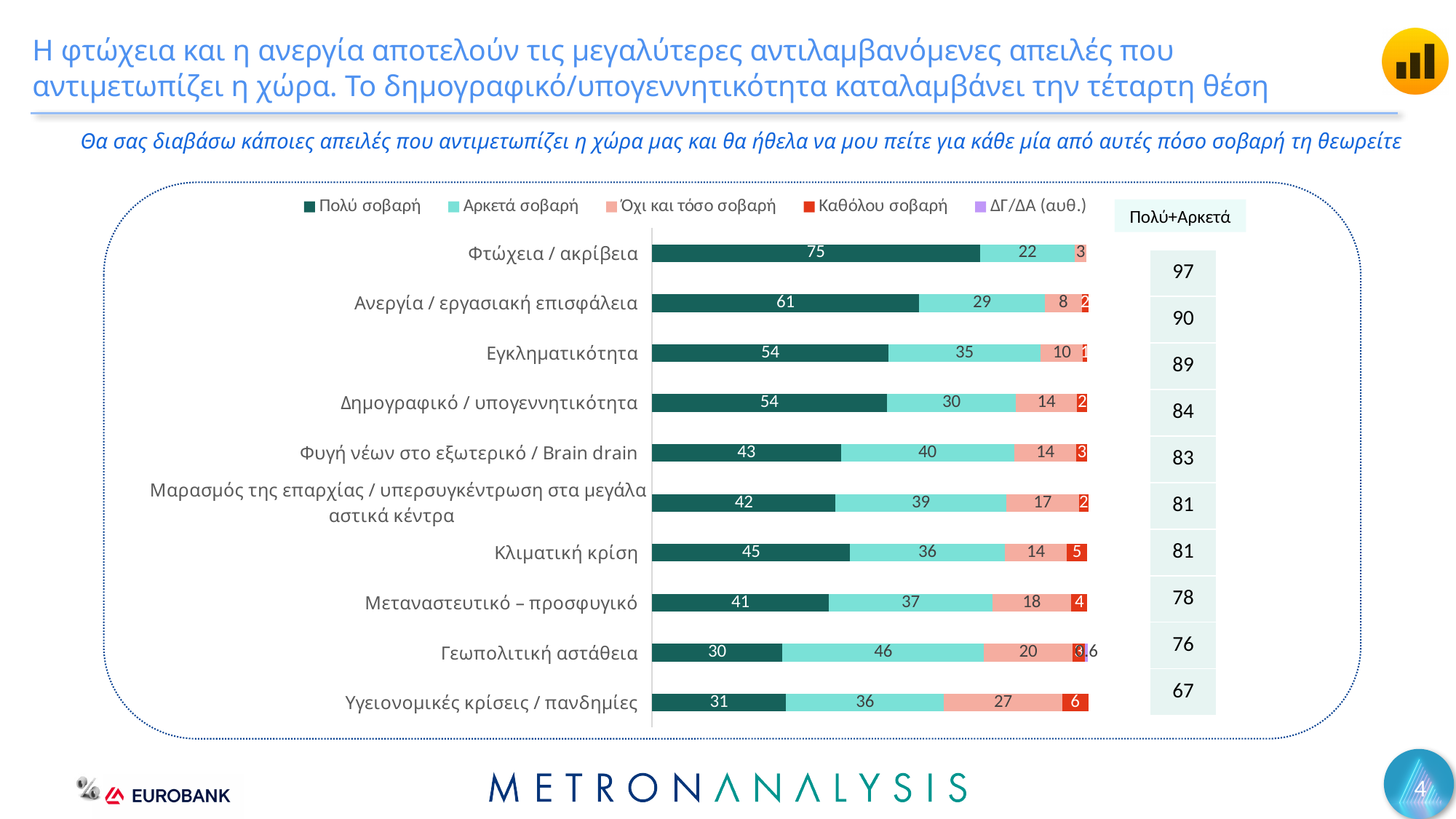
How many series does the legend list? 5 Which category has the lowest 'Πολύ+Αρκετά' value? Υγειονομικές κρίσεις / πανδημίες Which category has the highest 'Πολύ σοβαρή' value? Φτώχεια / ακρίβεια What is the 'Αρκετά σοβαρή' value for 'Γεωπολιτική αστάθεια'? 46 What is the 'Καθόλου σοβαρή' value for 'Υγειονομικές κρίσεις / πανδημίες'? 6 Which has a larger 'Όχι και τόσο σοβαρή' value: 'Υγειονομικές κρίσεις / πανδημίες' or 'Γεωπολιτική αστάθεια'? Υγειονομικές κρίσεις / πανδημίες What is the 'Πολύ σοβαρή' value for 'Φτώχεια / ακρίβεια'? 75 What is the 'Πολύ+Αρκετά' value shown for 'Δημογραφικό / υπογεννητικότητα'? 84 What type of chart is shown on the slide? Stacked bar chart How many categories (threats) are shown in the chart? 10 What is the heading of the column of values to the right of the bars? Πολύ+Αρκετά What is the difference between the 'Πολύ σοβαρή' values for 'Φτώχεια / ακρίβεια' and 'Ανεργία / εργασιακή επισφάλεια'? 14